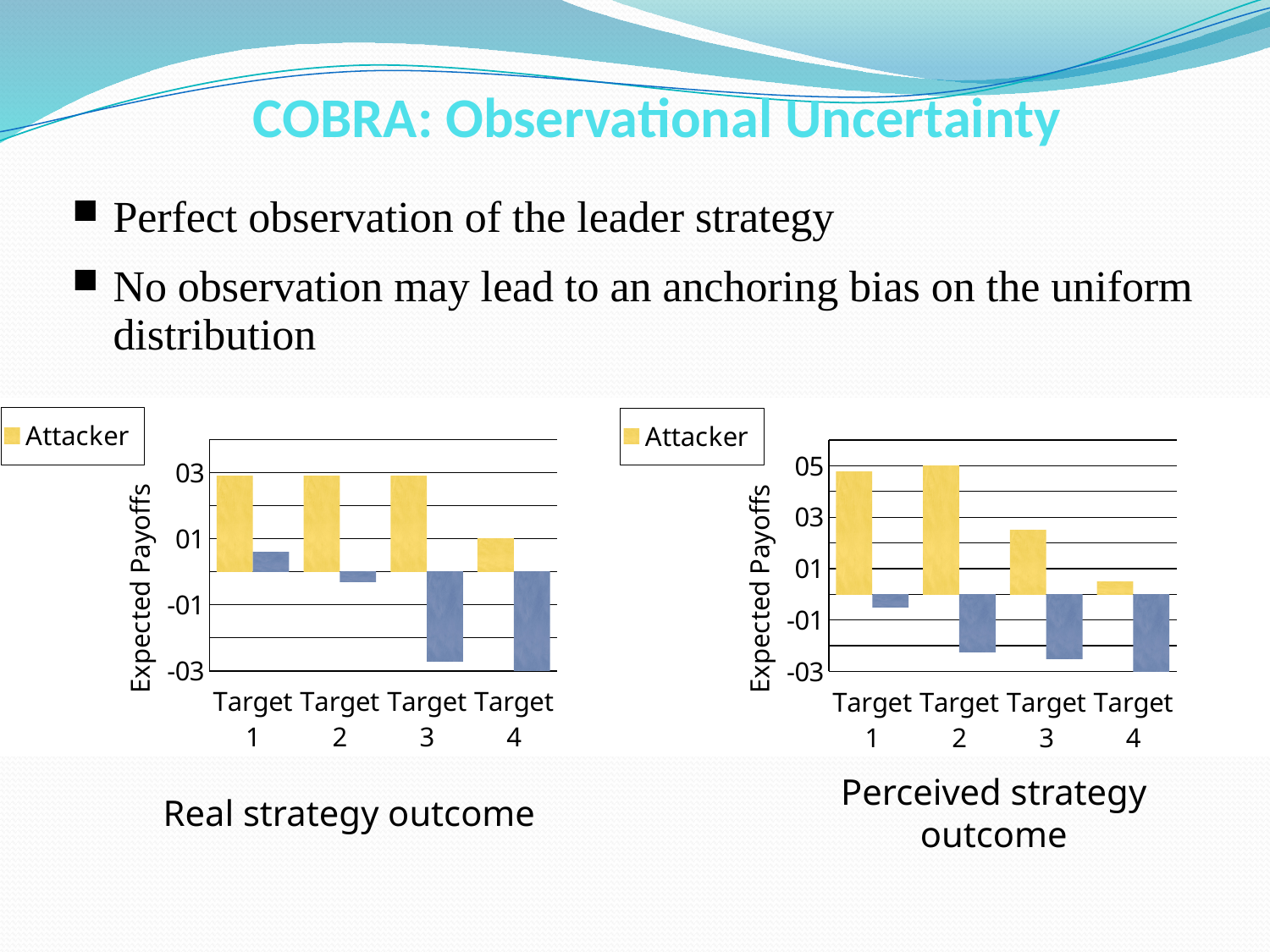
What is the y-axis label on the 'Real strategy outcome' chart? Expected Payoffs How many target categories are shown on the x axis of the 'Perceived strategy outcome' chart? 4 In the 'Real strategy outcome' chart, which is larger, the Attacker value for Target 2 or for Target 4? Target 2 In the 'Real strategy outcome' chart, which target has the lowest Attacker value? Target 4 In the 'Perceived strategy outcome' chart, which is larger, the Attacker value for Target 1 or for Target 3? Target 1 In the 'Perceived strategy outcome' chart, which target has the lowest Attacker value? Target 4 In the 'Real strategy outcome' chart, is the Attacker value for Target 1 greater or less than 01? greater In the 'Perceived strategy outcome' chart, is the Attacker value for Target 4 greater or less than 01? less In the 'Perceived strategy outcome' chart, is the Attacker value for Target 3 greater or less than 01? greater What kind of chart is the 'Real strategy outcome' chart? bar chart What series name is shown in the legend of the 'Perceived strategy outcome' chart? Attacker